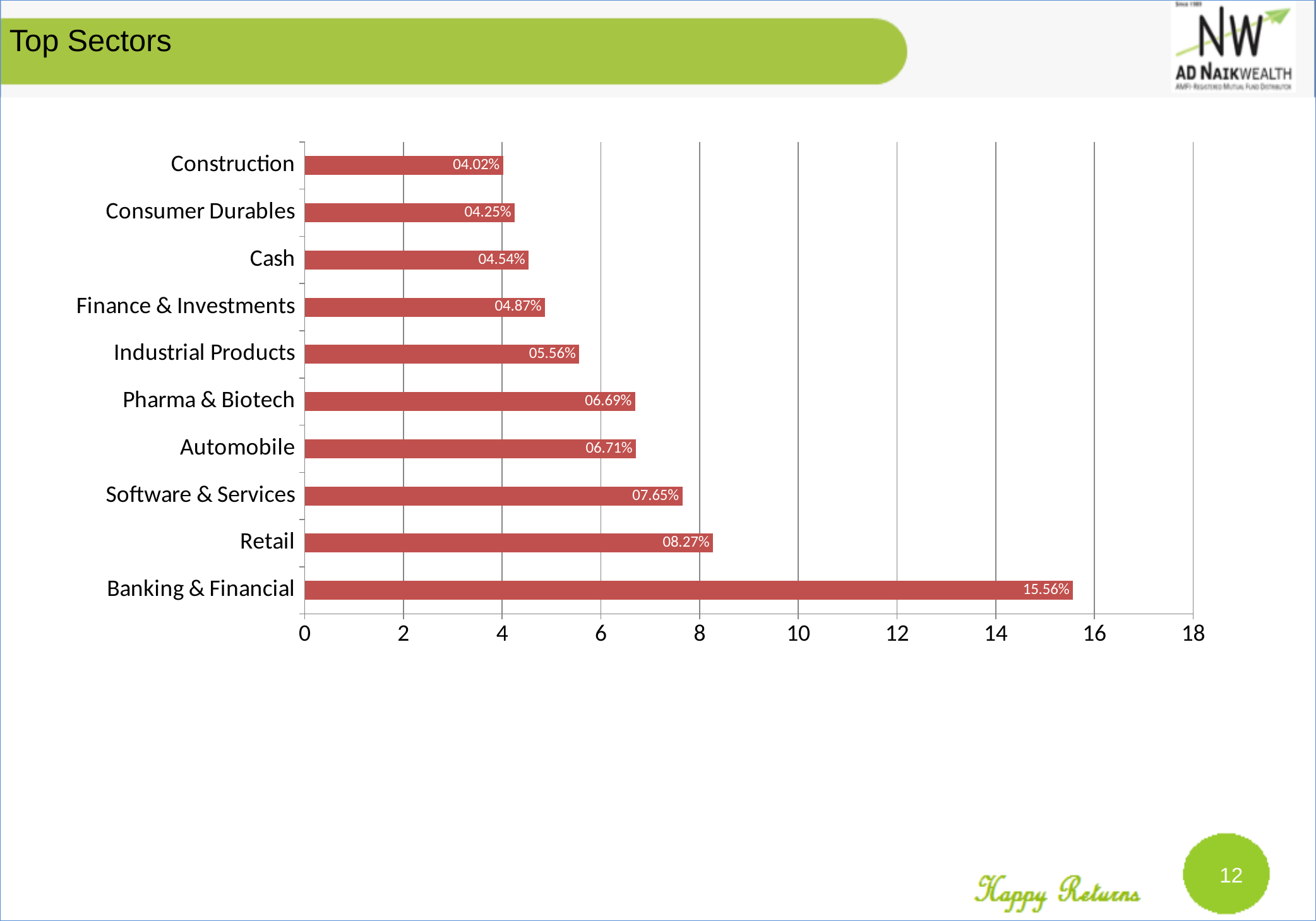
What is the value for Industrial Products? 05.56% What kind of chart is shown on the slide? bar chart Is the value for Software & Services greater or less than 6? greater What is the value for Banking & Financial? 15.56% Which sector has the lowest value? Construction What is the title of the slide containing the chart? Top Sectors What is the difference between the values for Retail and Software & Services? 0.62% How many sectors are shown in the chart? 10 What is the value for Cash? 04.54% What is the difference between the values for Banking & Financial and Retail? 7.29% Which is larger, the value for Retail or the value for Industrial Products? Retail Which sector has the highest value? Banking & Financial